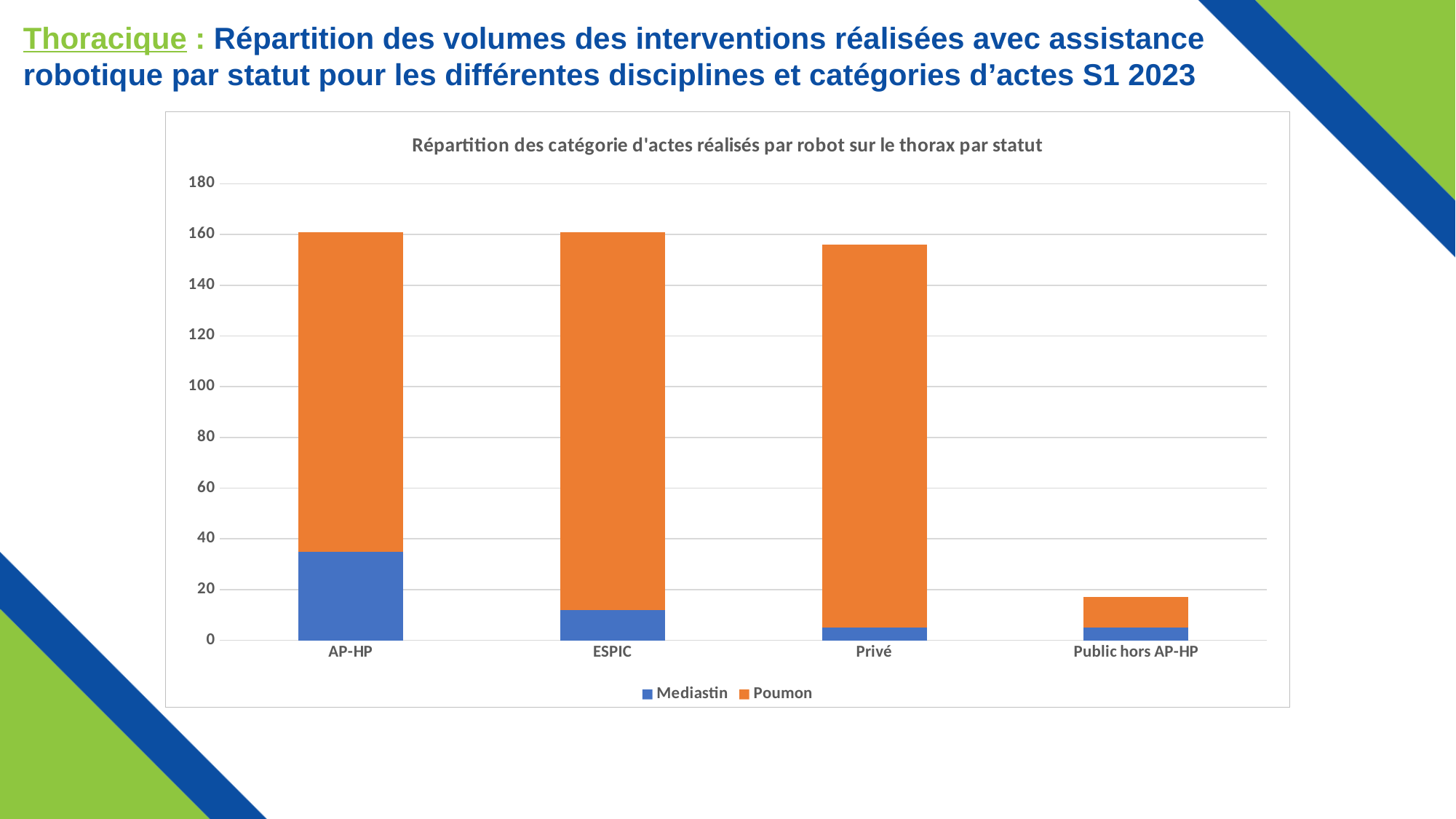
Is the Mediastin value for AP-HP greater or less than 20? greater Is the total value for Public hors AP-HP greater or less than 20? less What kind of chart is shown on the slide? Stacked bar chart Is the Mediastin value for ESPIC greater or less than 20? less Which series is shown in orange in the chart? Poumon Which has the larger Mediastin value, AP-HP or ESPIC? AP-HP Which category has the highest Mediastin value? AP-HP Which has the larger total stacked bar, Privé or Public hors AP-HP? Privé Which category has the lowest total stacked bar? Public hors AP-HP How many series does the chart legend list? 2 How many categories are shown on the x axis of the chart? 4